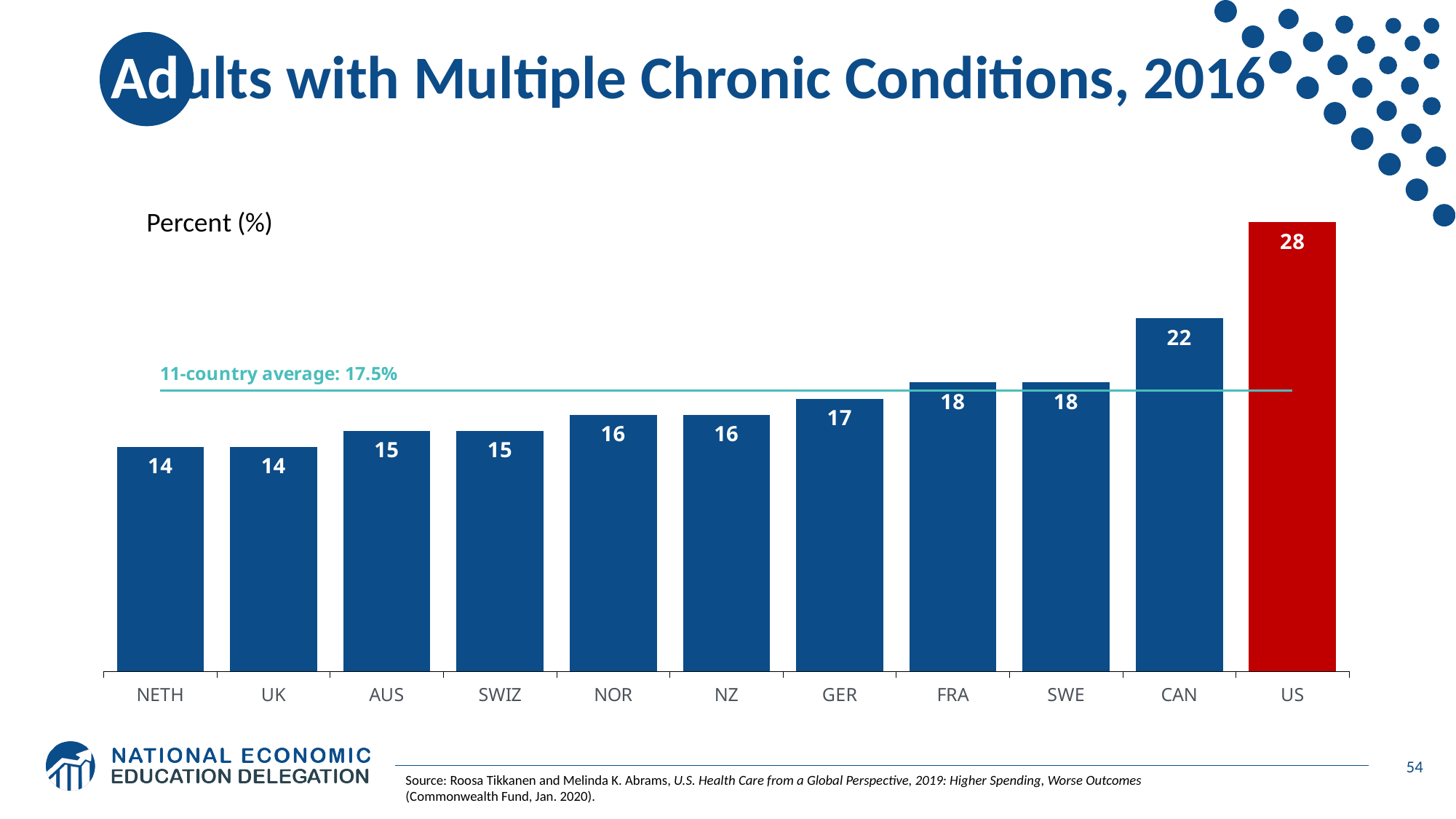
How many countries are shown on the chart? 11 What is the difference between the values for the US and CAN? 6 Which country's bar is coloured red? US What is the value for the US? 28 Do the values rise or fall from left to right along the x axis? rise What kind of chart is shown on the slide? bar chart Which is larger, the value for NOR or the value for FRA? FRA What is the 11-country average shown on the chart? 17.5% What is the value for CAN? 22 Which country has the highest value? US What is the value for GER? 17 What is the difference between the values for SWE and NETH? 4